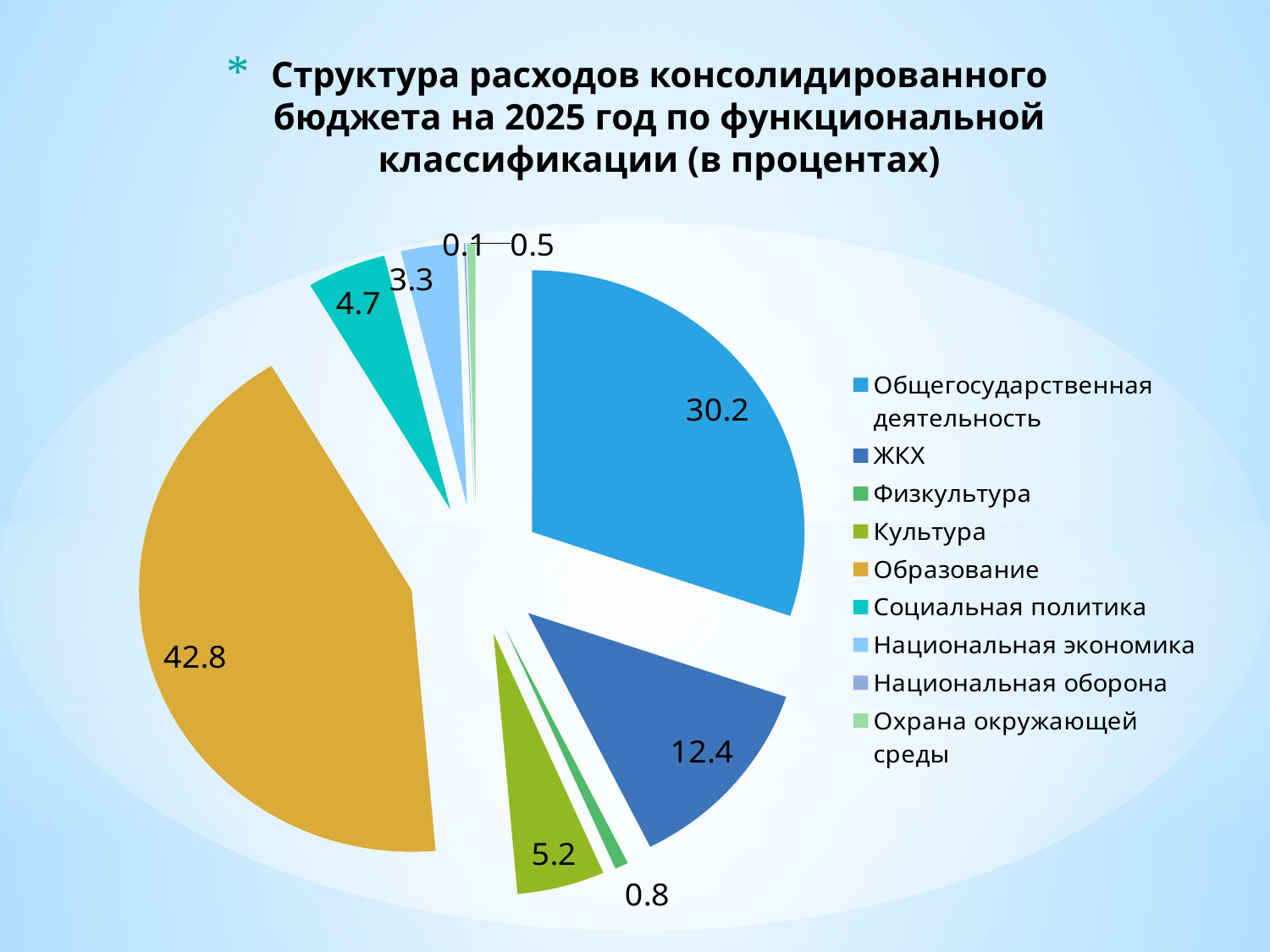
What is the value for Образование? 42.8 What year does the chart title refer to? 2025 What is the value for ЖКХ? 12.4 What is the value for Культура? 5.2 Which category has the largest slice of the pie? Образование Which is larger, the value for ЖКХ or the value for Культура? ЖКХ What is the value for Социальная политика? 4.7 What is the value for Общегосударственная деятельность? 30.2 How many categories does the legend list? 9 What kind of chart is shown on the slide? pie chart What is the value for Национальная экономика? 3.3 What is the difference between the values for Образование and Общегосударственная деятельность? 12.6